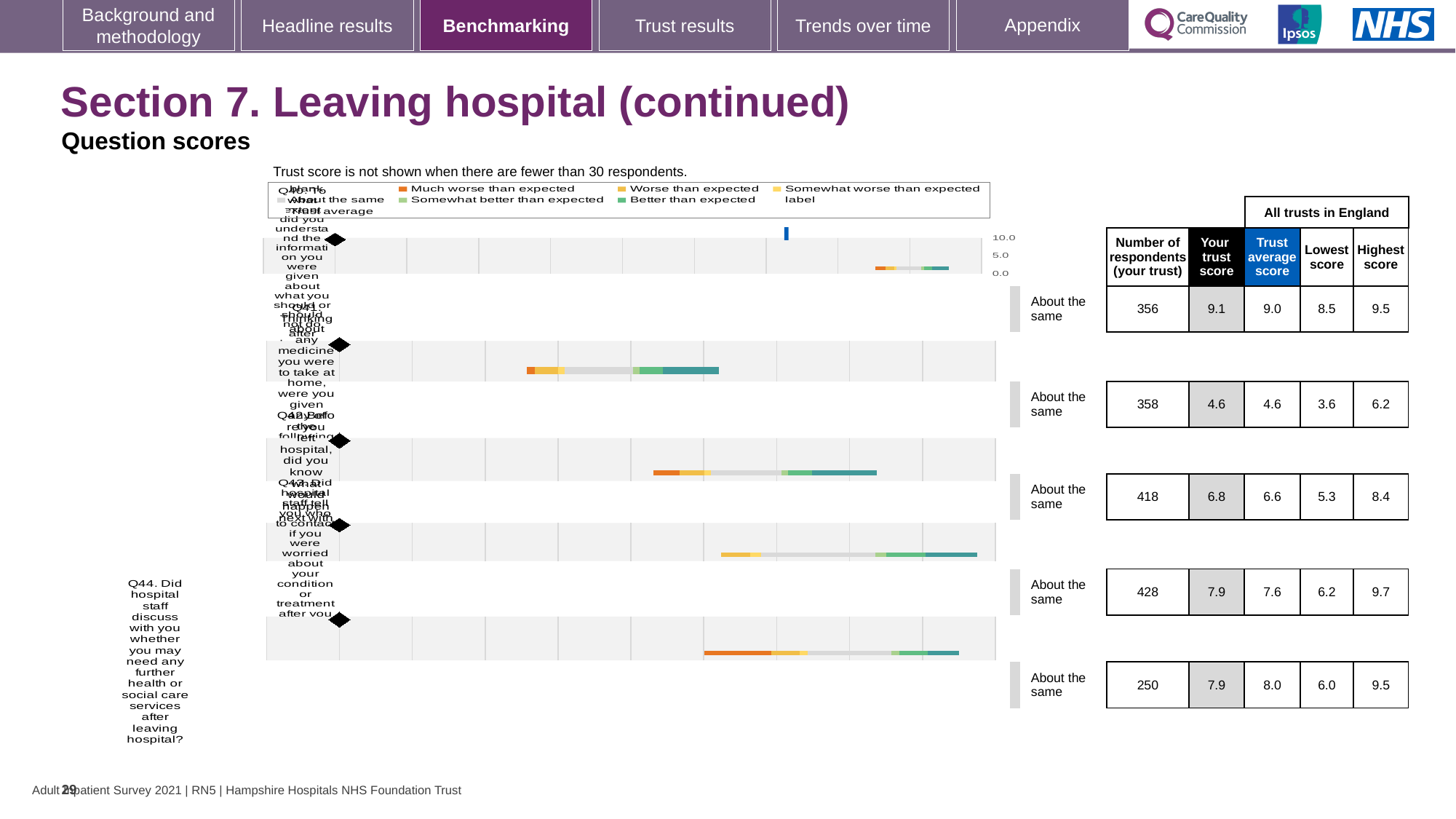
What is the trust score for Q44 (whether staff discussed further health or social care services after leaving hospital)? 7.9 What benchmark category is shown for every question row in the chart? About the same Which question row has the lowest 'Your trust score' in the chart? Q41 (second row), 4.6 For Q44, is the trust score (7.9) larger or smaller than the trust average score (8.0)? smaller Which question row has the highest 'Your trust score' in the chart? Q40 (first row), 9.1 What is the trust average score for the first question row (Q40) in the chart? 9.0 How many respondents answered Q44 at this trust? 250 What is the highest score across all trusts in England for the second question row (Q41)? 6.2 What is the difference between the highest score (9.7) and the lowest score (6.2) for the fourth question row (Q43)? 3.5 How many questions (rows) are plotted in the benchmarking chart? 5 What kind of chart is used to show the question scores on this slide? bar chart Which legend entry is shown in orange in the chart? Much worse than expected